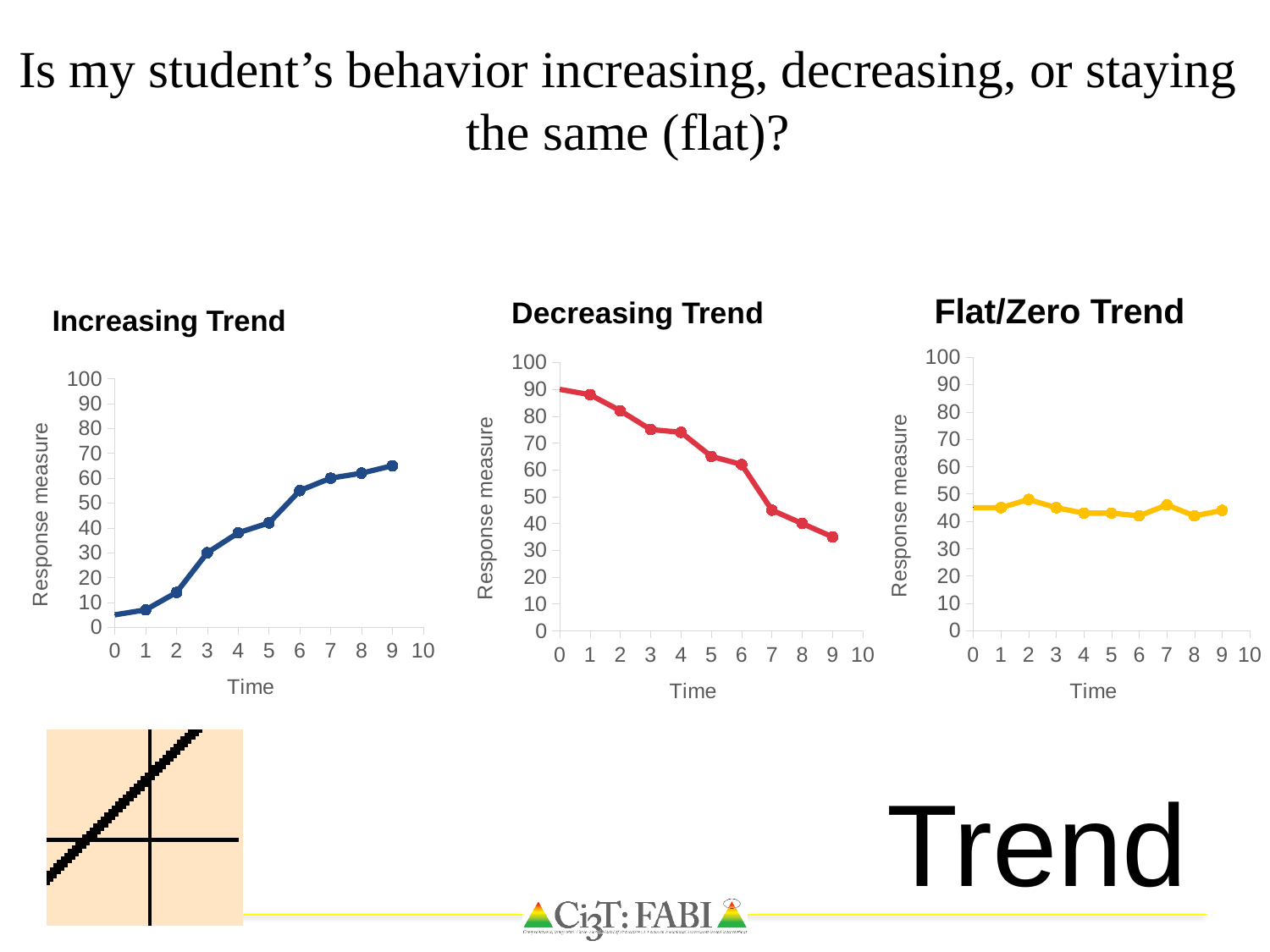
In the Increasing Trend chart, do the values rise or fall as Time increases? rise In the Decreasing Trend chart, is the value at Time 0 greater or less than 80? greater In the Decreasing Trend chart, do the values rise or fall as Time increases? fall What is the label on the vertical axis of the Flat/Zero Trend chart? Response measure In the Increasing Trend chart, is the value at Time 9 greater or less than 60? greater How many data points are plotted in the Decreasing Trend chart? 10 In the Decreasing Trend chart, which is larger: the value at Time 3 or the value at Time 7? Time 3 In the Flat/Zero Trend chart, do the values rise, fall, or stay roughly flat as Time increases? stay roughly flat In the Decreasing Trend chart, at which Time is the response measure lowest? 9 In the Flat/Zero Trend chart, is the value at Time 5 greater or less than 50? less What kind of chart is the Increasing Trend chart? line chart In the Increasing Trend chart, at which Time is the response measure highest? 9